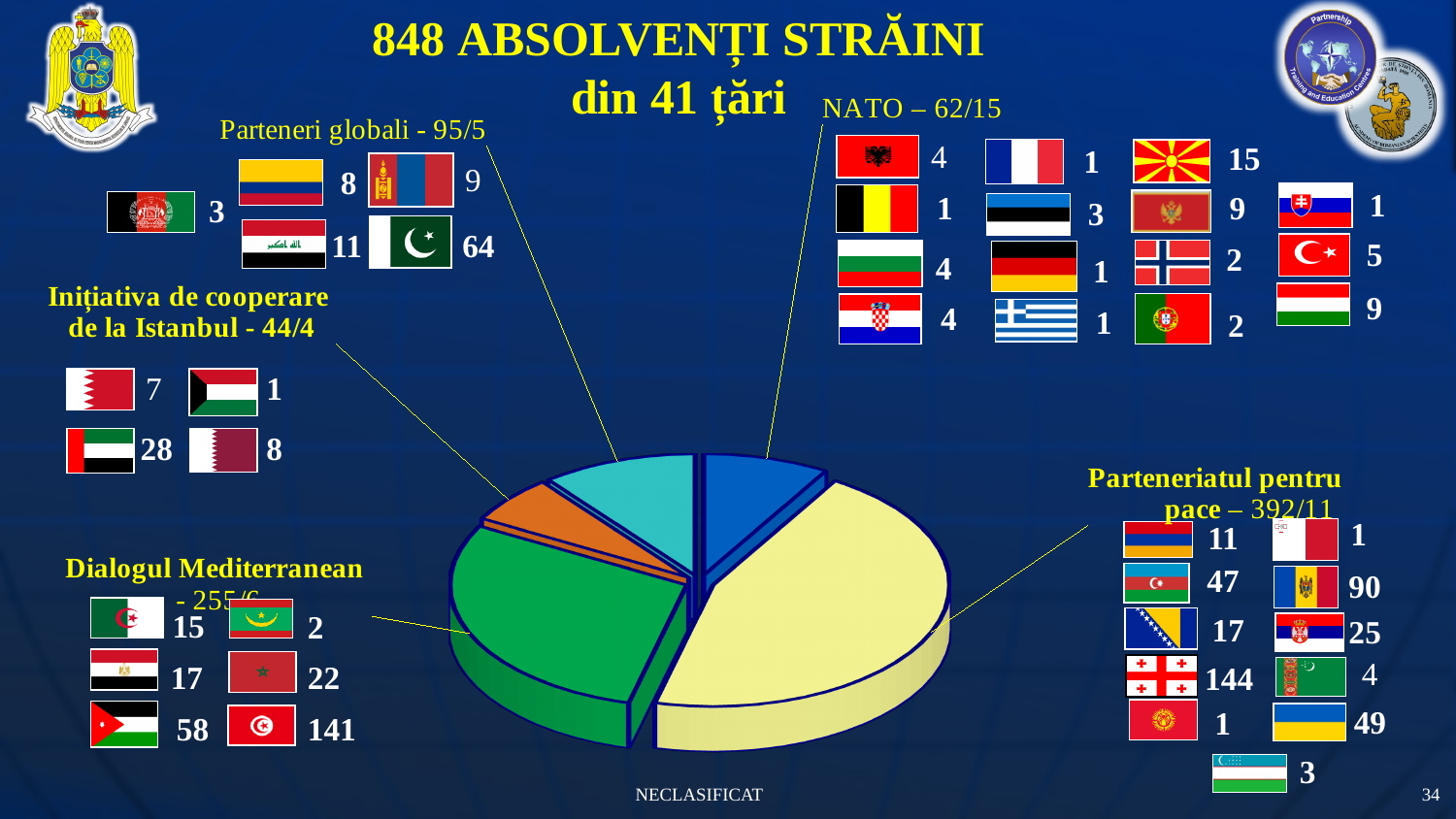
How many graduates are attributed to NATO in the pie chart? 62 How many graduates are attributed to Dialogul Mediterranean? 255 What is the total number of foreign graduates represented by the pie chart? 848 What is the difference in graduates between Parteneriatul pentru pace and Dialogul Mediterranean? 137 How many graduates are attributed to Parteneri globali? 95 Which group has the largest slice of the pie chart? Parteneriatul pentru pace What colour is the largest slice of the pie chart? yellow How many slices does the pie chart have? 5 Which group has the smallest slice of the pie chart? Inițiativa de cooperare de la Istanbul What is the difference in graduates between Parteneri globali and Inițiativa de cooperare de la Istanbul? 51 What kind of chart is shown on the slide? pie chart Which has more graduates, NATO or Parteneri globali? Parteneri globali